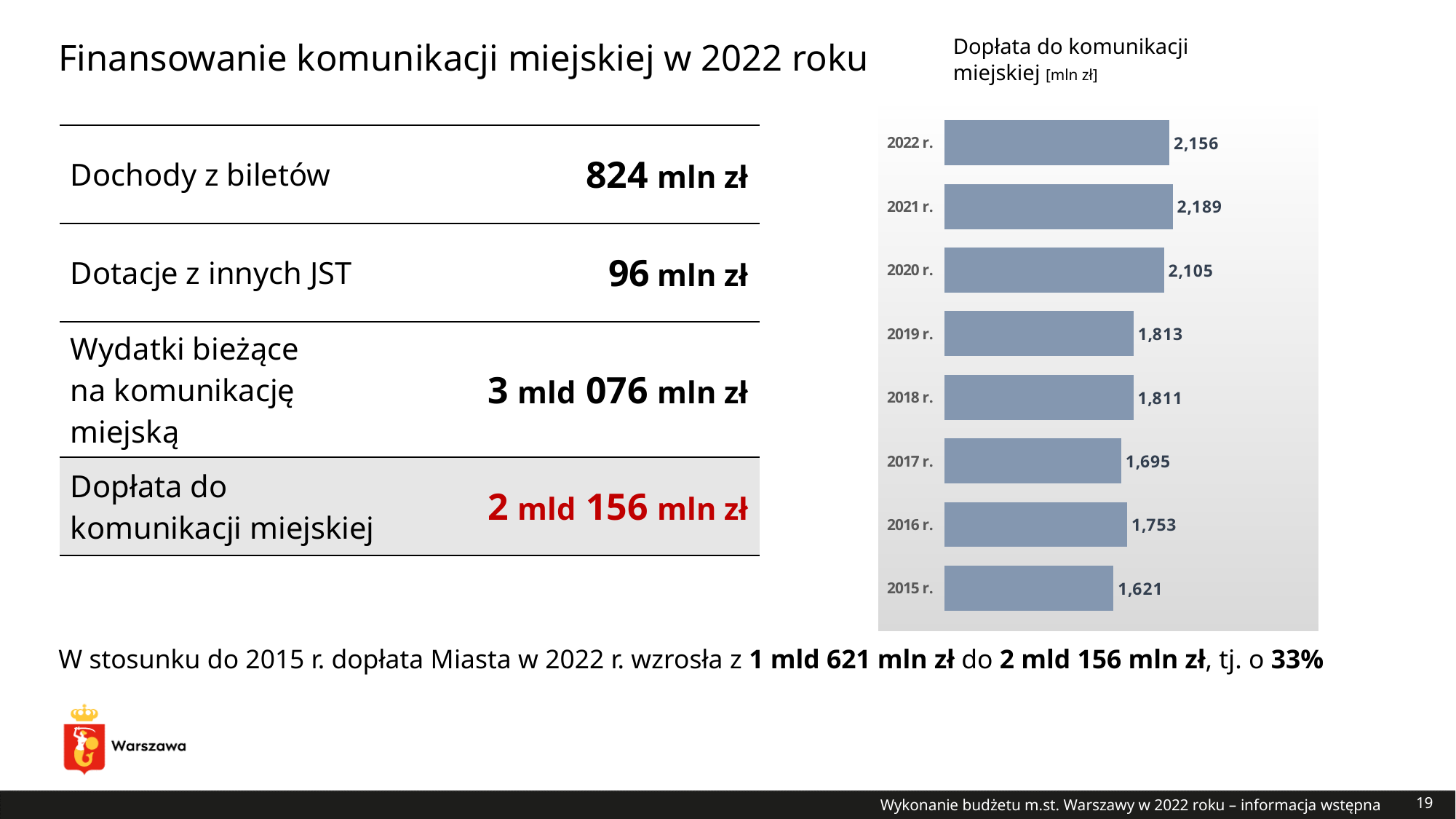
What is the difference between the values for 2022 r. and 2015 r.? 535 How many years are shown in the chart? 8 What is the value for 2019 r. in the chart? 1,813 What is the value for 2022 r. in the chart? 2,156 What is the value for 2015 r. in the chart? 1,621 What kind of chart is shown on the slide? Bar chart Do the values generally rise or fall from 2015 r. to 2022 r.? Rise Which year has the highest value in the chart? 2021 r. Which year has the lowest value in the chart? 2015 r. What is the difference between the values for 2021 r. and 2020 r.? 84 Which is larger, the value for 2016 r. or the value for 2017 r.? 2016 r. What unit is given in the chart title? mln zł